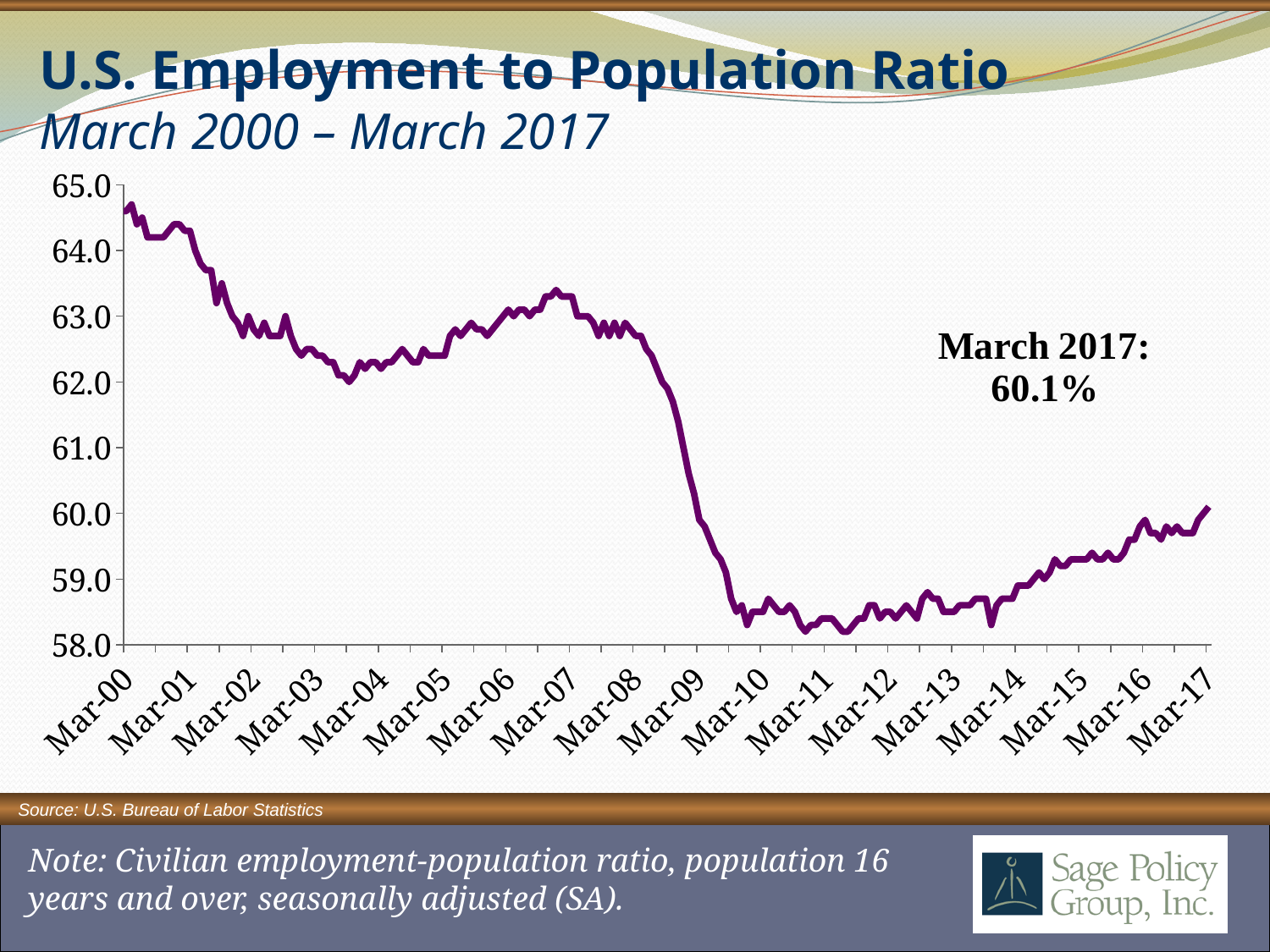
Is the value at Mar-15 greater or less than 59.0? greater How many labels are shown on the x axis? 18 Is the value at Mar-00 greater or less than 64.0? greater What is the employment to population ratio for March 2017 according to the annotation on the chart? 60.1% Among the labeled x-axis points, which has the highest value? Mar-00 Does the line rise or fall between Mar-14 and Mar-17? rise Is the value at Mar-07 greater or less than 63.0? greater Does the line rise or fall between Mar-08 and Mar-10? fall Which is larger, the value at Mar-00 or the value at Mar-17? Mar-00 What kind of chart is shown on the slide? line chart